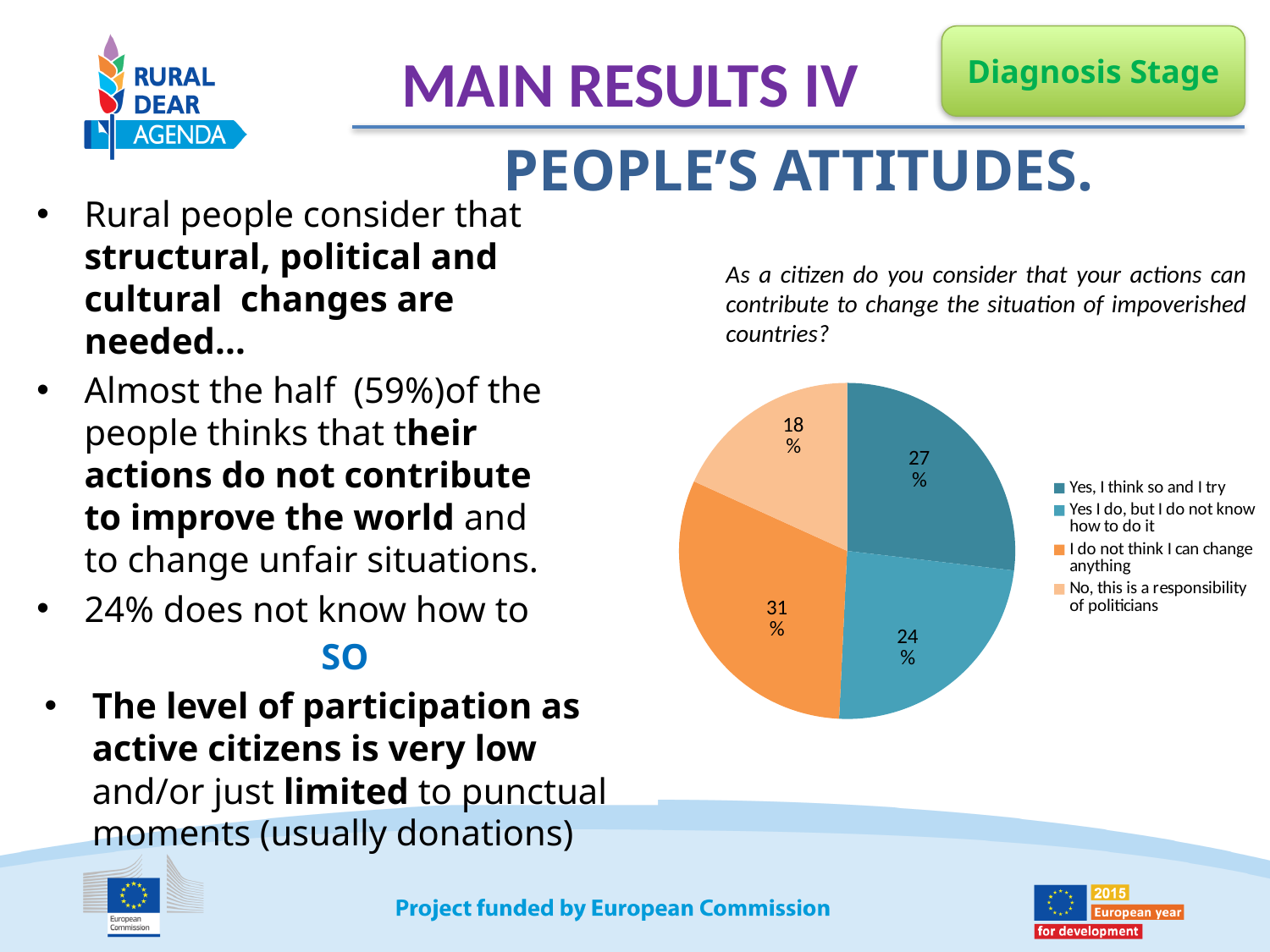
What is the difference in percentage points between "I do not think I can change anything" and "No, this is a responsibility of politicians"? 13 What share of respondents answered "I do not think I can change anything"? 31% How many slices does the pie chart have? 4 Which response has the largest slice of the pie? I do not think I can change anything What kind of chart is shown on the slide? pie chart Which response has the smallest slice of the pie? No, this is a responsibility of politicians What share of respondents answered "Yes I do, but I do not know how to do it"? 24% What share of respondents answered "No, this is a responsibility of politicians"? 18% Which is larger: the share for "Yes, I think so and I try" or the share for "Yes I do, but I do not know how to do it"? Yes, I think so and I try What share of respondents answered "Yes, I think so and I try"? 27% How many entries does the legend of the pie chart list? 4 What question is the pie chart answering, according to the text above it? As a citizen do you consider that your actions can contribute to change the situation of impoverished countries?